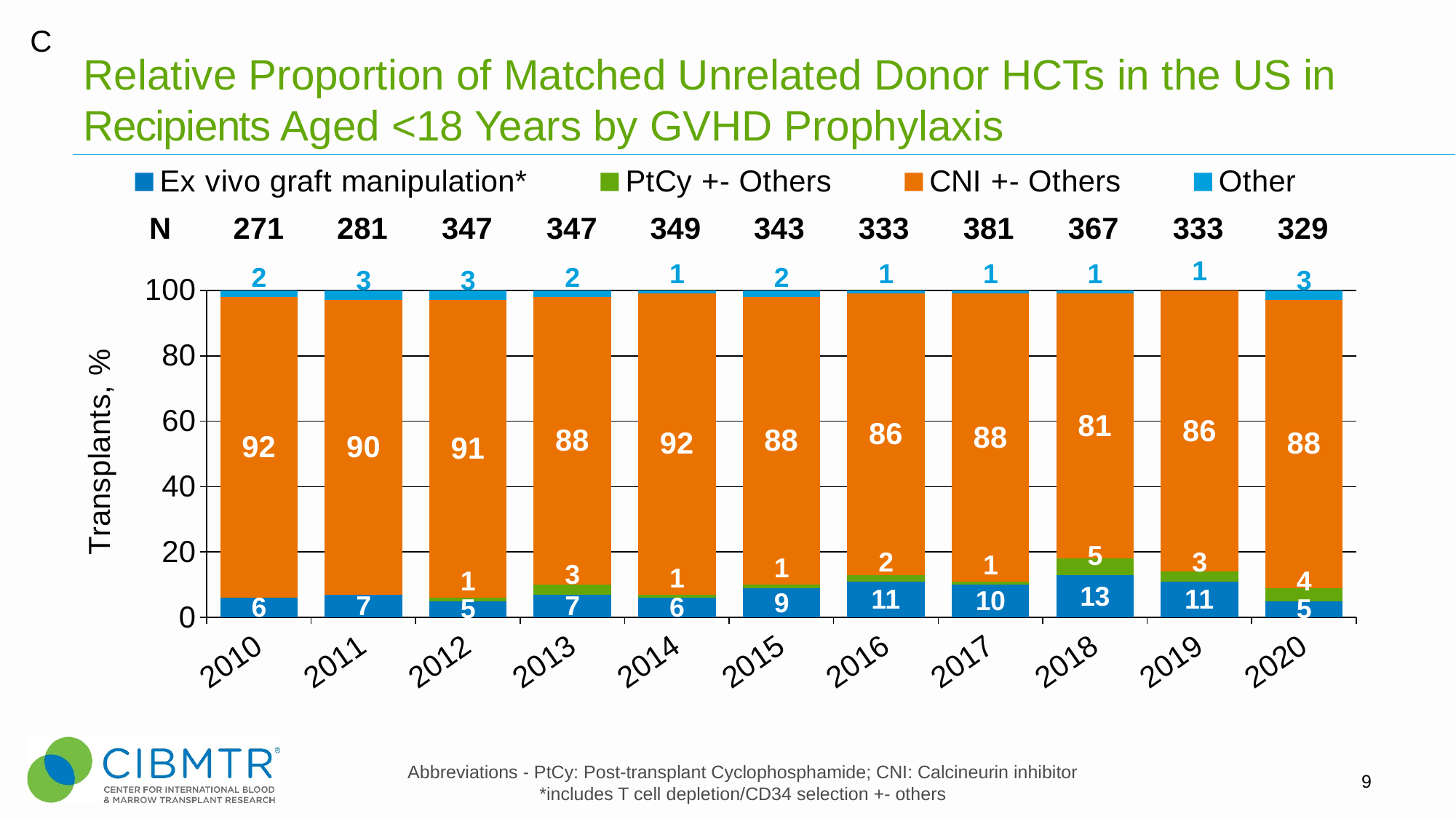
Which is larger, the Ex vivo graft manipulation* value in 2015 or in 2020? 2015 What is the value for Ex vivo graft manipulation* in 2016? 11 In which year is the CNI +- Others percentage lowest? 2018 What is the value for PtCy +- Others in 2020? 4 In which year is the Ex vivo graft manipulation* percentage highest? 2018 What percentage of transplants in 2018 used CNI +- Others as GVHD prophylaxis? 81 Which series is shown in orange in the legend? CNI +- Others How many series does the legend list? 4 What kind of chart is shown on the slide? Stacked bar chart What is the difference between the CNI +- Others percentage in 2010 and in 2018? 11 What is the N (number of transplants) shown for 2017? 381 How many years are shown on the x axis? 11